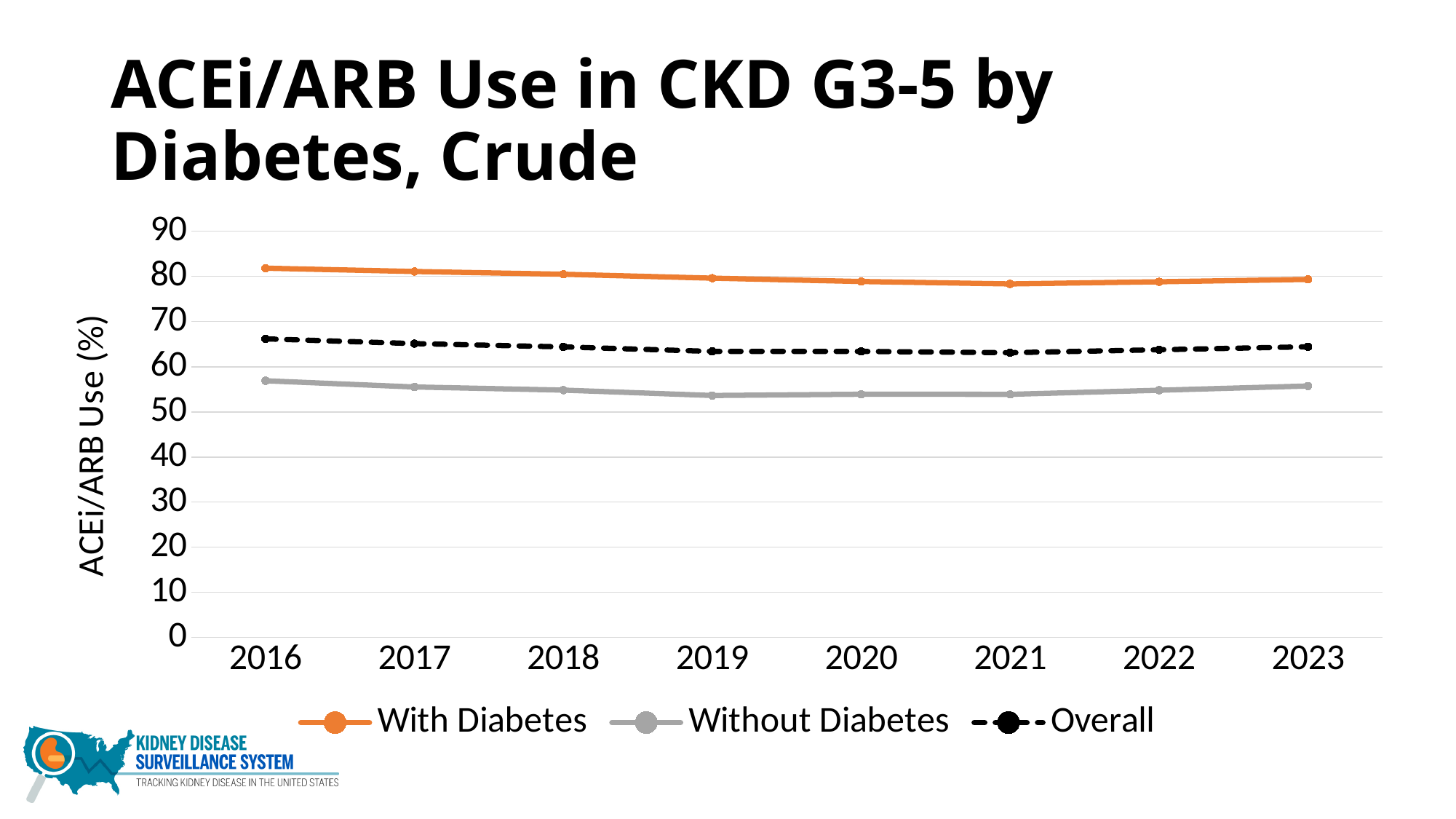
Which series has the highest ACEi/ARB use across all years? With Diabetes How many series does the legend list? 3 Is the value for Without Diabetes in 2019 greater or less than 60? less In 2020, which is larger: the value for With Diabetes or the value for Without Diabetes? With Diabetes Is the value for With Diabetes in 2021 greater or less than 80? less Is the value for Overall in 2021 greater or less than 70? less Does the With Diabetes line rise or fall from 2016 to 2021? fall Which series has the lowest ACEi/ARB use across all years? Without Diabetes What is the label on the y axis? ACEi/ARB Use (%) How many years are plotted along the x axis? 8 What kind of chart is shown on the slide? line chart